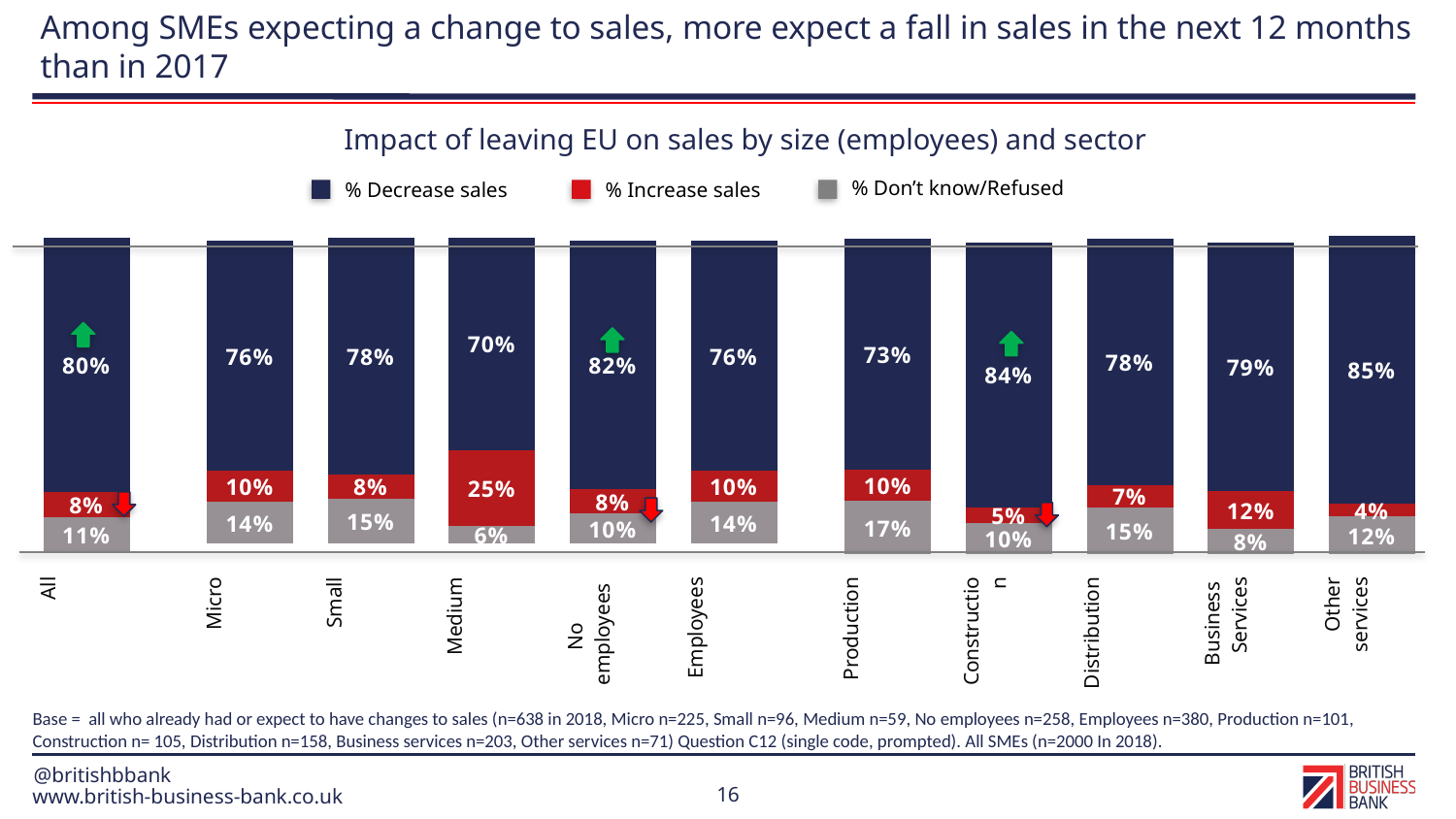
What is the difference between the % Decrease sales values for Construction and Production? 11 percentage points Which is larger, the % Don't know/Refused value for Small or for Business Services? Small How many series does the legend list? 3 What kind of chart is shown on the slide? Stacked bar chart Which category has the highest % Increase sales value? Medium What is the % Don't know/Refused value for Production? 17% Which category has the highest % Decrease sales value? Other services How many categories are shown on the x axis? 11 What is the % Decrease sales value for Construction? 84% What is the % Decrease sales value for Other services? 85% Which category has the lowest % Decrease sales value? Medium What is the % Increase sales value for Medium? 25%